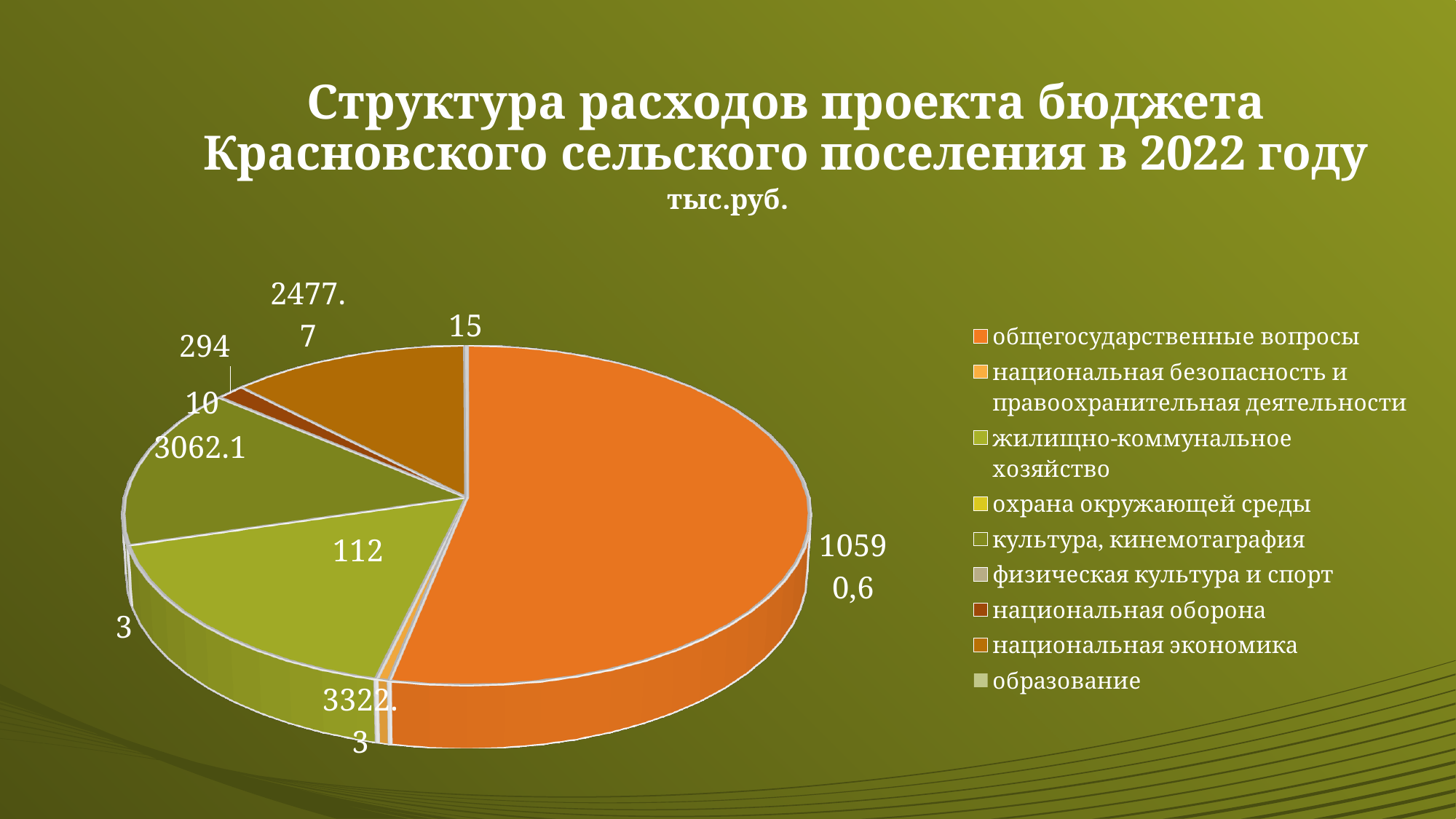
Which is larger, the value for общегосударственные вопросы or the value for национальная экономика? общегосударственные вопросы What is the value for национальная экономика? 2477.7 What is the value for общегосударственные вопросы? 10590,6 What kind of chart is shown on the slide? pie chart In what units are the values of the pie chart given? тыс.руб. What is the value for образование? 15 What is the title of the chart on the slide? Структура расходов проекта бюджета Красновского сельского поселения в 2022 году How many categories does the legend of the pie chart list? 9 What is the smallest value labelled on the pie chart? 3 Which category has the largest slice of the pie chart? общегосударственные вопросы What is the largest value labelled on the pie chart? 10590,6